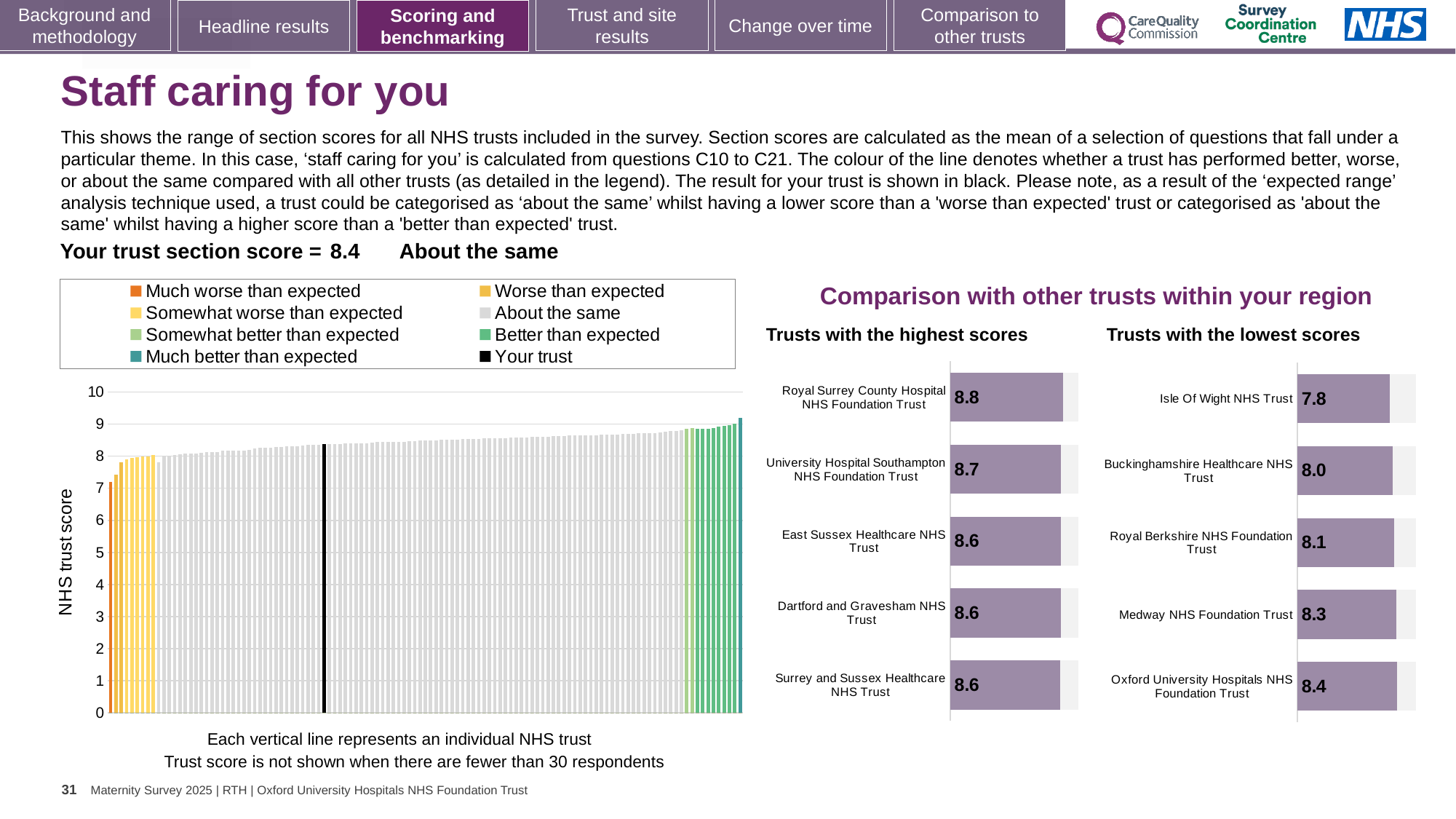
In the 'Trusts with the lowest scores' chart, which trust has the lowest score? Isle Of Wight NHS Trust In the 'Trusts with the highest scores' chart, what is the difference between the scores of Royal Surrey County Hospital NHS Foundation Trust and Surrey and Sussex Healthcare NHS Trust? 0.2 In the 'Trusts with the lowest scores' chart, what is the score for Medway NHS Foundation Trust? 8.3 In the 'Trusts with the lowest scores' chart, what is the difference between the scores of Oxford University Hospitals NHS Foundation Trust and Isle Of Wight NHS Trust? 0.6 In the 'Trusts with the highest scores' chart, what is the score for Royal Surrey County Hospital NHS Foundation Trust? 8.8 In the large 'NHS trust score' chart on the left, is the black bar for your trust greater or less than 8? greater In the 'Trusts with the lowest scores' chart, which has the higher score: Medway NHS Foundation Trust or Buckinghamshire Healthcare NHS Trust? Medway NHS Foundation Trust In the 'Trusts with the lowest scores' chart, what is the score for Isle Of Wight NHS Trust? 7.8 In the 'Trusts with the highest scores' chart, how many trusts are shown? 5 In the large 'NHS trust score' chart on the left, how many entries does the legend list? 8 In the 'Trusts with the highest scores' chart, which trust has the highest score? Royal Surrey County Hospital NHS Foundation Trust What kind of chart is the large 'NHS trust score' chart on the left? Bar chart